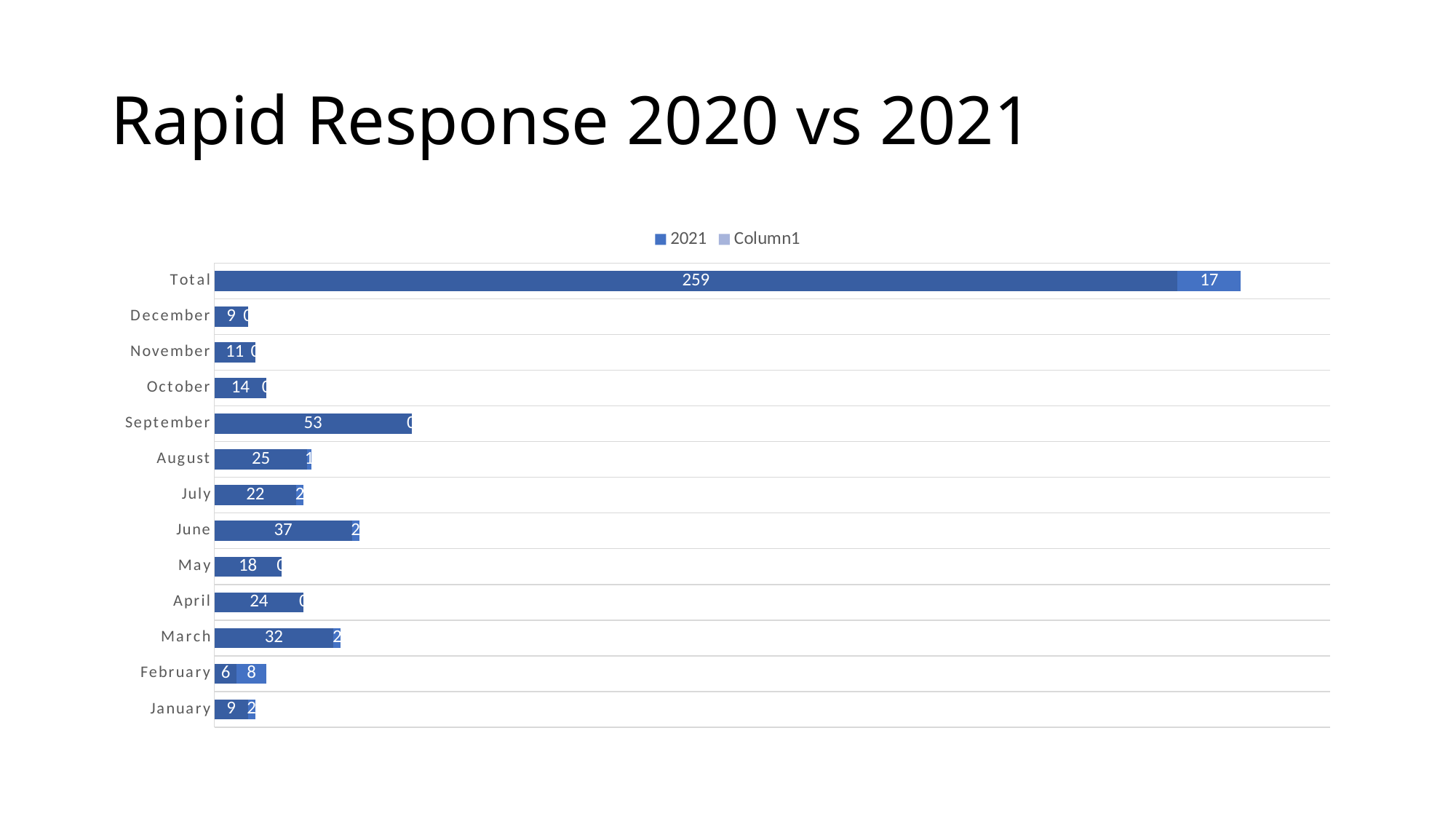
What is the combined total of the Total bar across both series? 276 What kind of chart is shown on the slide? Bar chart How many series does the legend list? 2 How many categories are shown on the vertical axis? 13